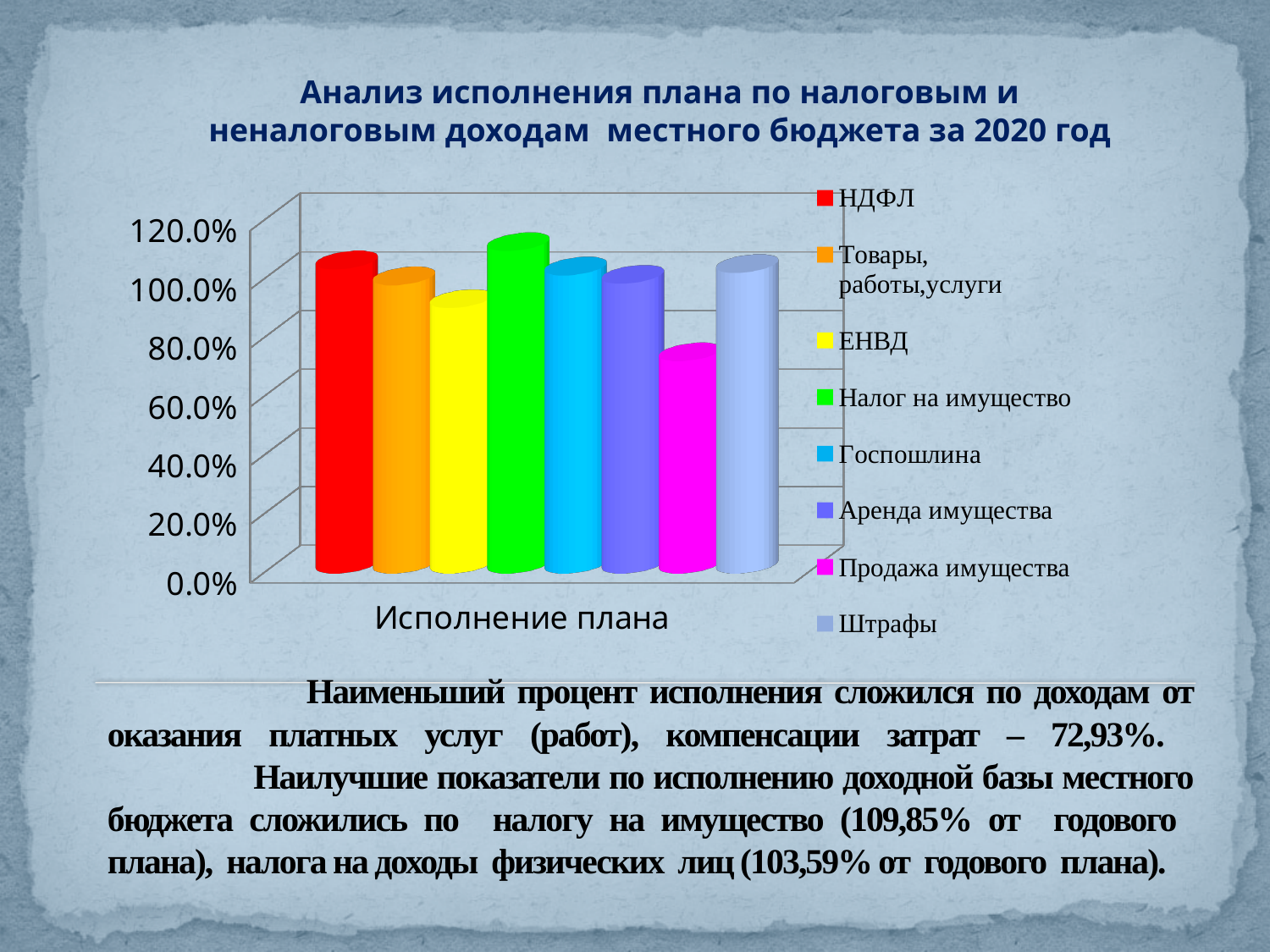
Is the value for Налог на имущество greater or less than 100.0%? greater Is the value for ЕНВД greater or less than 100.0%? less Is the value for Продажа имущества greater or less than 80.0%? less Which series has the lowest bar? Продажа имущества What colour is the bar for НДФЛ? red What is the category label shown on the x axis? Исполнение плана Which series has the highest bar? Налог на имущество Which is larger, the bar for Налог на имущество or the bar for ЕНВД? Налог на имущество How many series does the legend list? 8 What kind of chart is shown on the slide? bar chart Which is larger, the bar for НДФЛ or the bar for Продажа имущества? НДФЛ